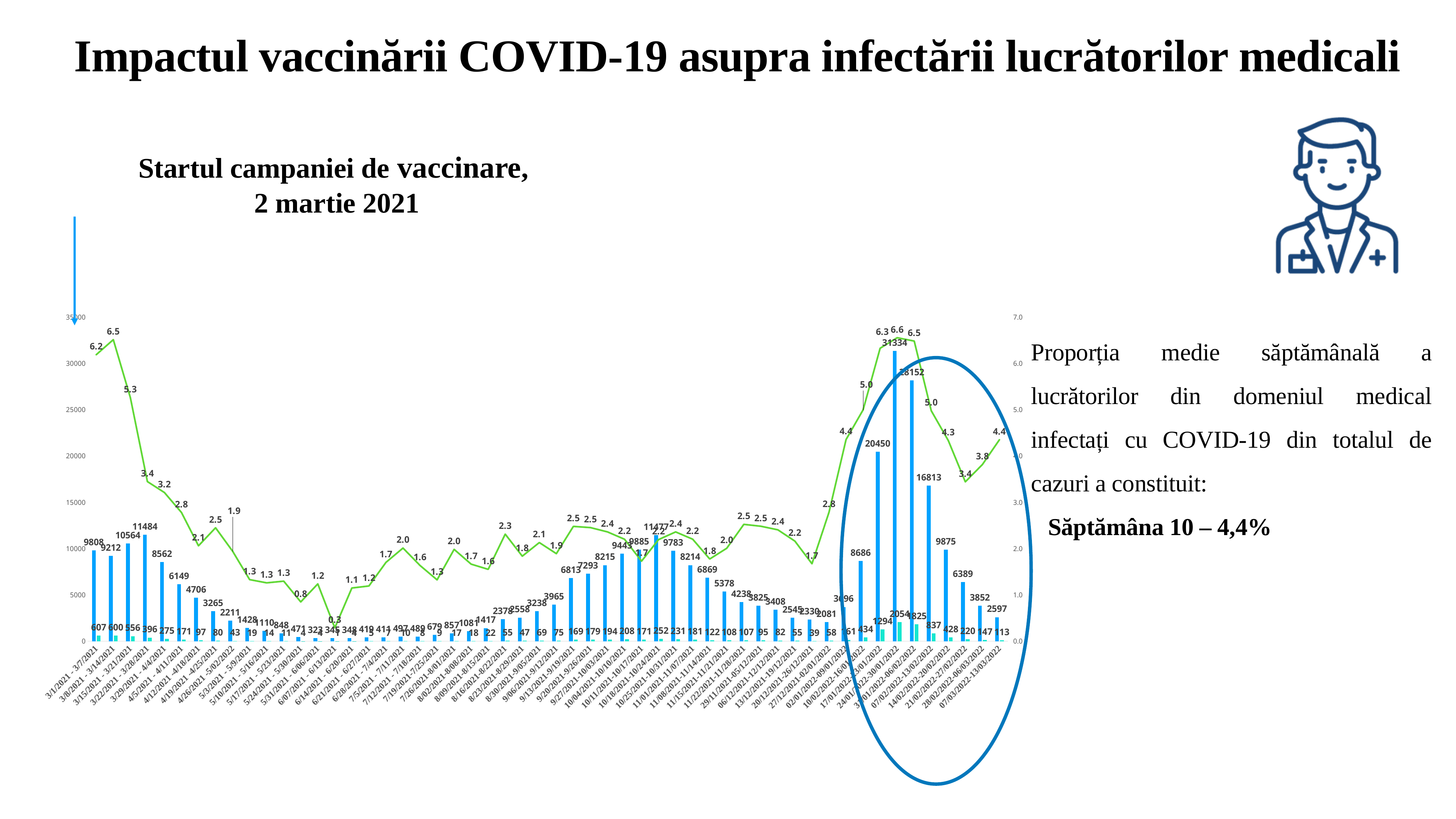
What is the value of the tall blue bar for the week 31/01/2022 - 06/02/2022? 28152 What is the value of the small teal bar for the week 31/01/2022 - 06/02/2022? 1825 Which week has the larger tall blue bar value: 3/1/2021 - 3/7/2021 or 3/8/2021 - 3/14/2021? 3/1/2021 - 3/7/2021 Is the tall blue bar for the week 24/01/2022 - 30/01/2022 greater or less than 15000? greater What is the value of the tall blue bar for the week 3/22/2021 - 3/28/2021? 11484 What value does the green line show for the week 3/1/2021 - 3/7/2021? 6.2 What kind of chart is shown on the slide? A combined bar and line chart What is the lowest value shown on the green line? 0.3 What is the difference between the tall blue bar values for 31/01/2022 - 06/02/2022 and 07/02/2022 - 13/02/2022? 11339 What is the title of the slide containing the chart? Impactul vaccinării COVID-19 asupra infectării lucrătorilor medicali What value does the green line show for the last week, 07/03/2022 - 13/03/2022? 4.4 Which week has the highest value on the green line? 24/01/2022 - 30/01/2022